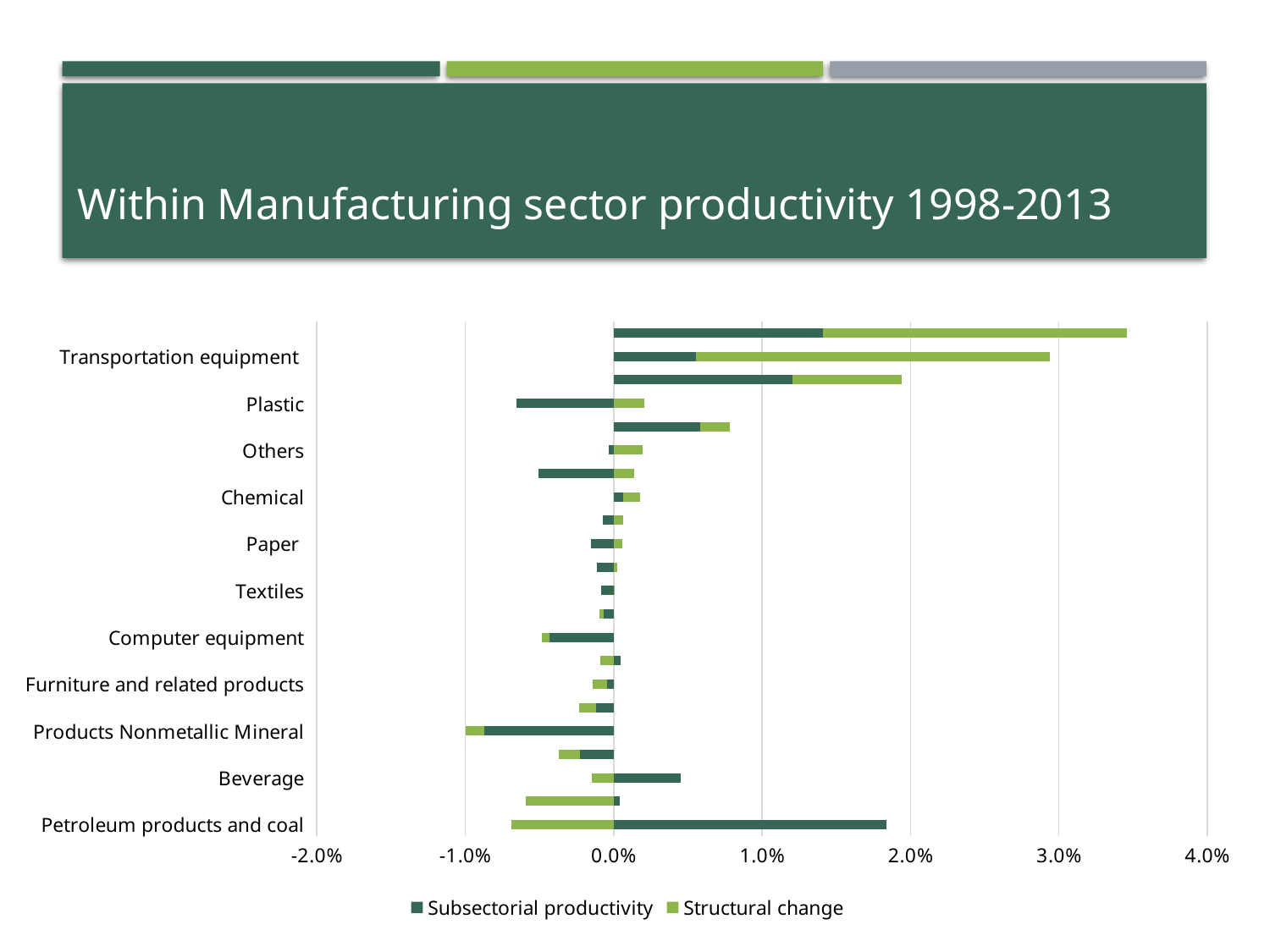
Is the Subsectorial productivity value for Petroleum products and coal greater or less than 1.0%? greater Is the Subsectorial productivity value for Products Nonmetallic Mineral greater or less than 0.0%? less Which labelled category has the lowest Subsectorial productivity value? Products Nonmetallic Mineral What is the title of the chart? Within Manufacturing sector productivity 1998-2013 Is the Subsectorial productivity value for Beverage greater or less than 1.0%? less How many series does the legend list? 2 Which has the larger Subsectorial productivity value, Transportation equipment or Plastic? Transportation equipment What kind of chart is shown on the slide? bar chart Which has the larger Subsectorial productivity value, Petroleum products and coal or Beverage? Petroleum products and coal Which series is shown in light green in the legend? Structural change Which labelled category has the highest Subsectorial productivity value? Petroleum products and coal